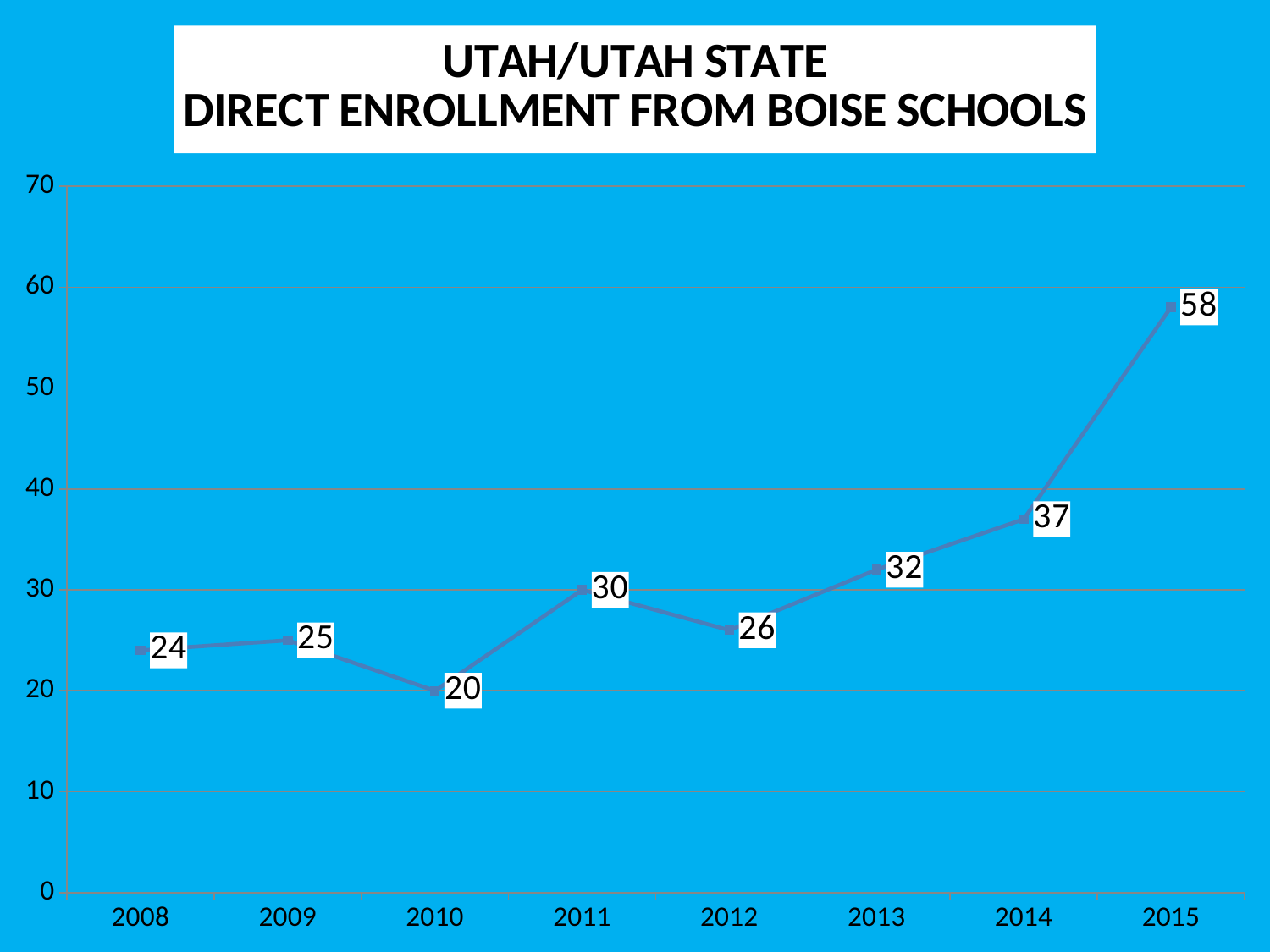
What is the difference between the 2015 and 2014 values? 21 What is the difference between the 2011 and 2010 values? 10 What is the title of the chart? UTAH/UTAH STATE DIRECT ENROLLMENT FROM BOISE SCHOOLS Which year has the lowest direct enrollment? 2010 What is the direct enrollment value for 2015? 58 What is the direct enrollment value for 2012? 26 What kind of chart is shown on the slide? Line chart Is the value for 2014 greater or less than 40? less How many years are plotted on the chart? 8 Which year has a larger value, 2009 or 2012? 2012 Which year has the highest direct enrollment? 2015 What is the direct enrollment value for 2010? 20